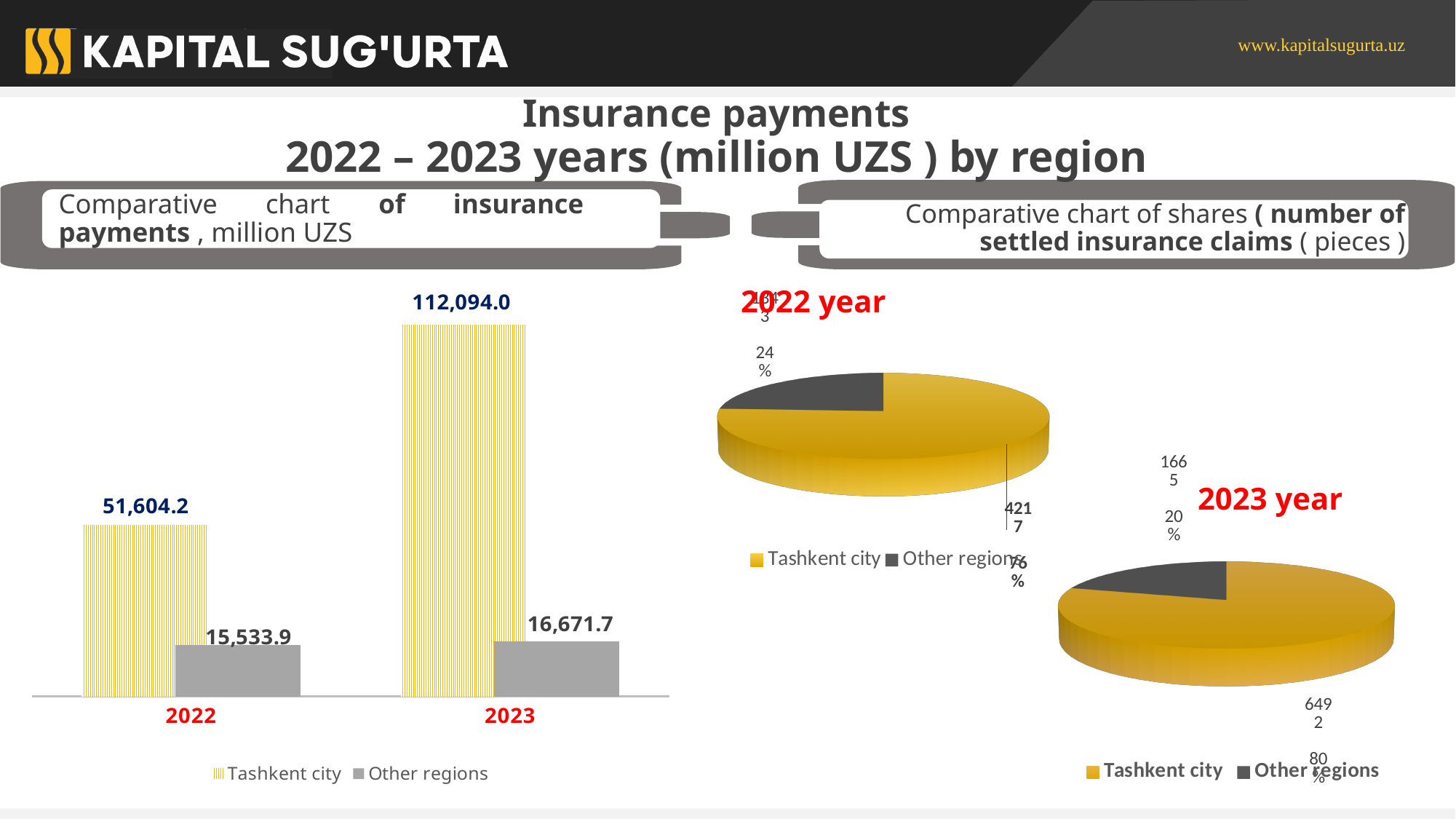
In the bar chart on the left, what is the value for Other regions in 2022? 15,533.9 In the bar chart on the left, which is larger: Tashkent city in 2022 or Other regions in 2023? Tashkent city in 2022 In the bar chart on the left, which bar is the lowest? Other regions in 2022 In the bar chart on the left, which bar is the highest? Tashkent city in 2023 In the bar chart on the left, what is the value for Tashkent city in 2023? 112,094.0 In the 2023 year pie chart, what share does Tashkent city have? 80% In the bar chart on the left, how many series does the legend list? 2 In the 2022 year pie chart, what share does Other regions have? 24% What kind of chart is the chart on the left of the slide? Bar chart In the bar chart on the left, what is the difference between Tashkent city and Other regions in 2023? 95,422.3 In the bar chart on the left, what is the value for Other regions in 2023? 16,671.7 In the bar chart on the left, what is the value for Tashkent city in 2022? 51,604.2